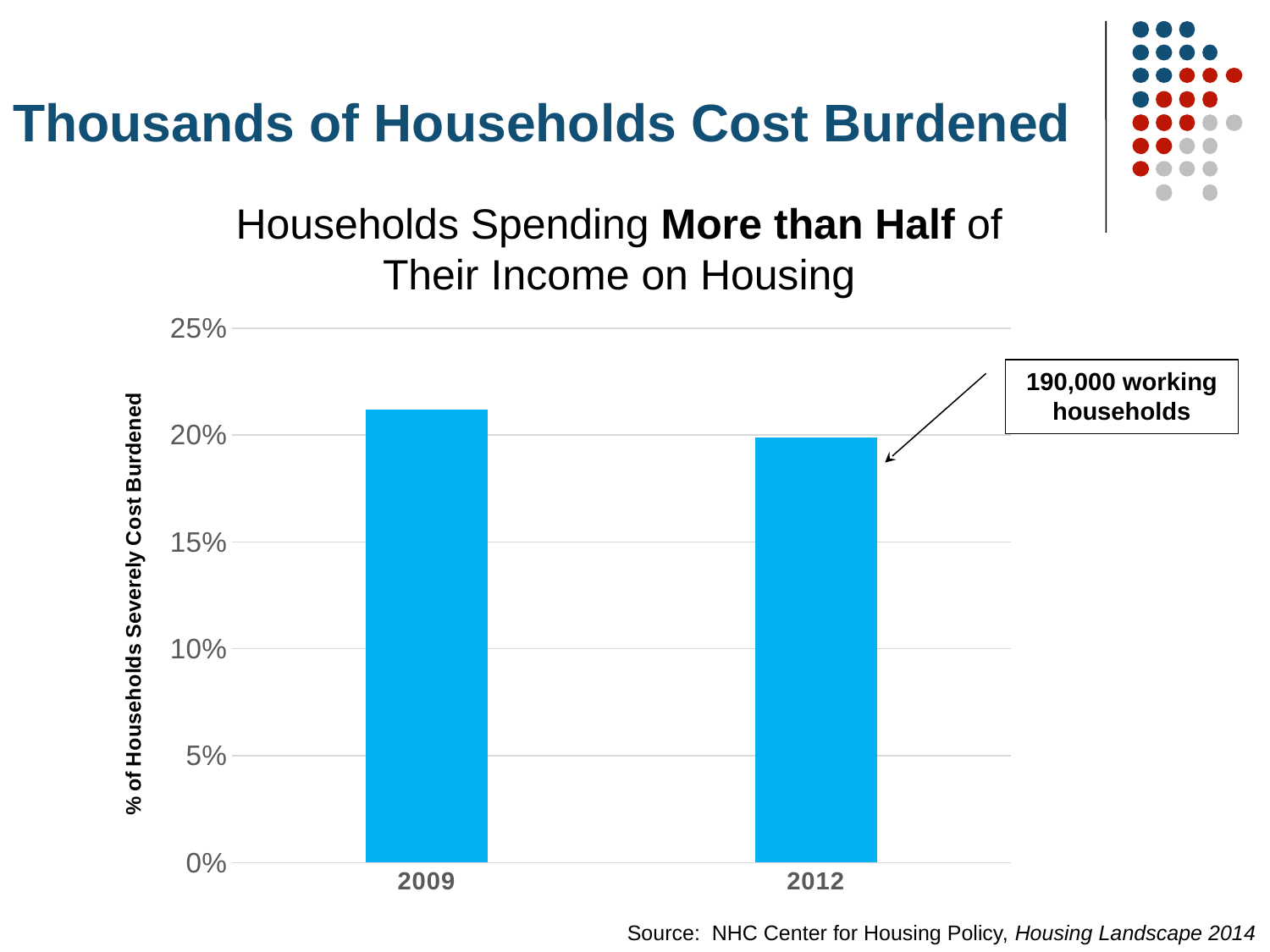
Is the value for 2012 greater or less than 15%? greater What is the title of the chart? Households Spending More than Half of Their Income on Housing Is the value for 2009 greater or less than 25%? less How many years are plotted on the chart? 2 Is the value for 2009 greater or less than 20%? greater Does the percentage of households severely cost burdened rise or fall from 2009 to 2012? fall What number of working households does the annotation on the 2012 bar give? 190,000 working households What kind of chart is shown on the slide? bar chart Is the value for 2009 larger or smaller than the value for 2012? larger Which year has the higher percentage of households severely cost burdened? 2009 Which year has the lower percentage of households severely cost burdened? 2012